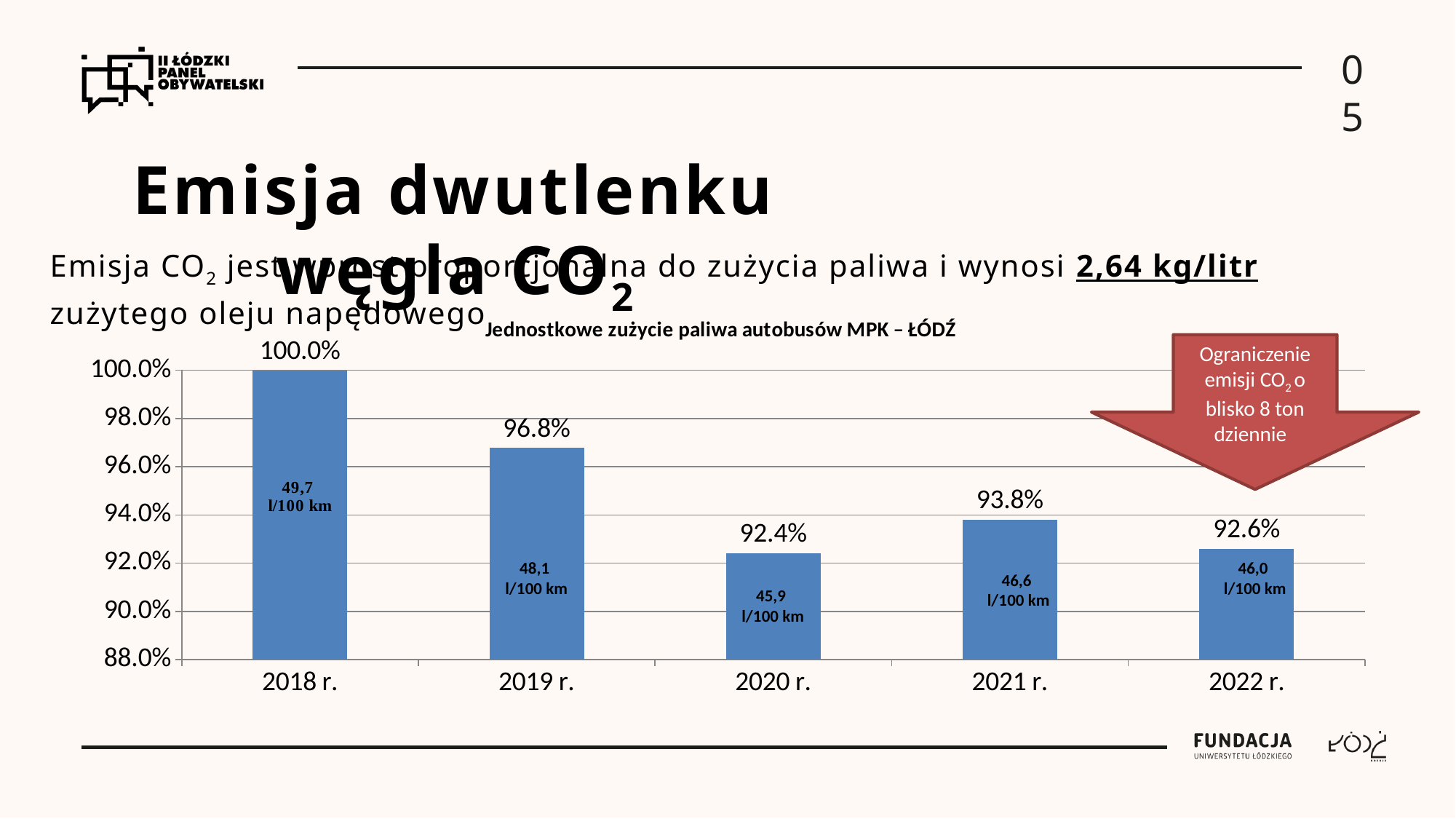
What is the value for 2019 r. in the chart 'Jednostkowe zużycie paliwa autobusów MPK – ŁÓDŹ'? 96.8% What is the difference between the values for 2018 r. and 2022 r.? 7.4% What is the value for 2021 r. in the chart? 93.8% Which year has the lowest value in the chart? 2020 r. Which year has the highest value in the chart? 2018 r. What fuel consumption in l/100 km is shown inside the bar for 2018 r.? 49,7 l/100 km What kind of chart is shown on the slide? Bar chart Which is larger, the value for 2021 r. or the value for 2022 r.? 2021 r. Do the values generally rise or fall from 2018 r. to 2020 r.? Fall What fuel consumption in l/100 km is shown inside the bar for 2020 r.? 45,9 l/100 km How many years are shown on the x axis of the chart? 5 What is the title of the chart on the slide? Jednostkowe zużycie paliwa autobusów MPK – ŁÓDŹ